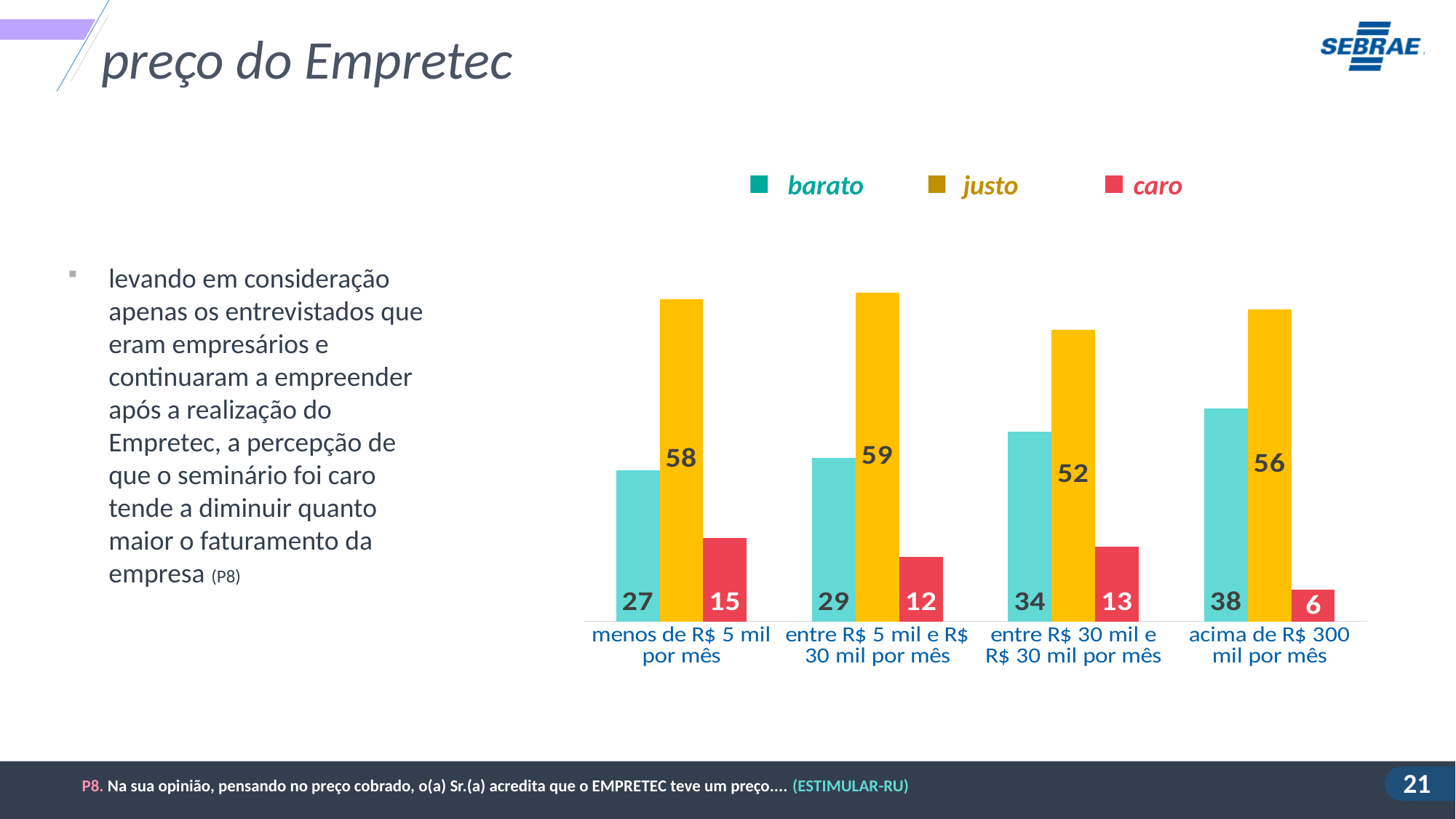
What is the difference between the "justo" and "barato" values in the "menos de R$ 5 mil por mês" category? 31 What is the value for "justo" in the "entre R$ 5 mil e R$ 30 mil por mês" category? 59 What is the value for "barato" in the "menos de R$ 5 mil por mês" category? 27 How many categories are shown on the x axis of the chart? 4 What kind of chart is shown on the slide? bar chart Which category has the highest value for "barato"? acima de R$ 300 mil por mês Do the "barato" values rise or fall from left to right across the categories? rise What is the value for "caro" in the "acima de R$ 300 mil por mês" category? 6 Which category has the lowest value for "caro"? acima de R$ 300 mil por mês Which is larger: the "caro" value for "menos de R$ 5 mil por mês" or the "caro" value for "entre R$ 5 mil e R$ 30 mil por mês"? menos de R$ 5 mil por mês How many series does the legend list? 3 Which series in the legend is shown in red? caro